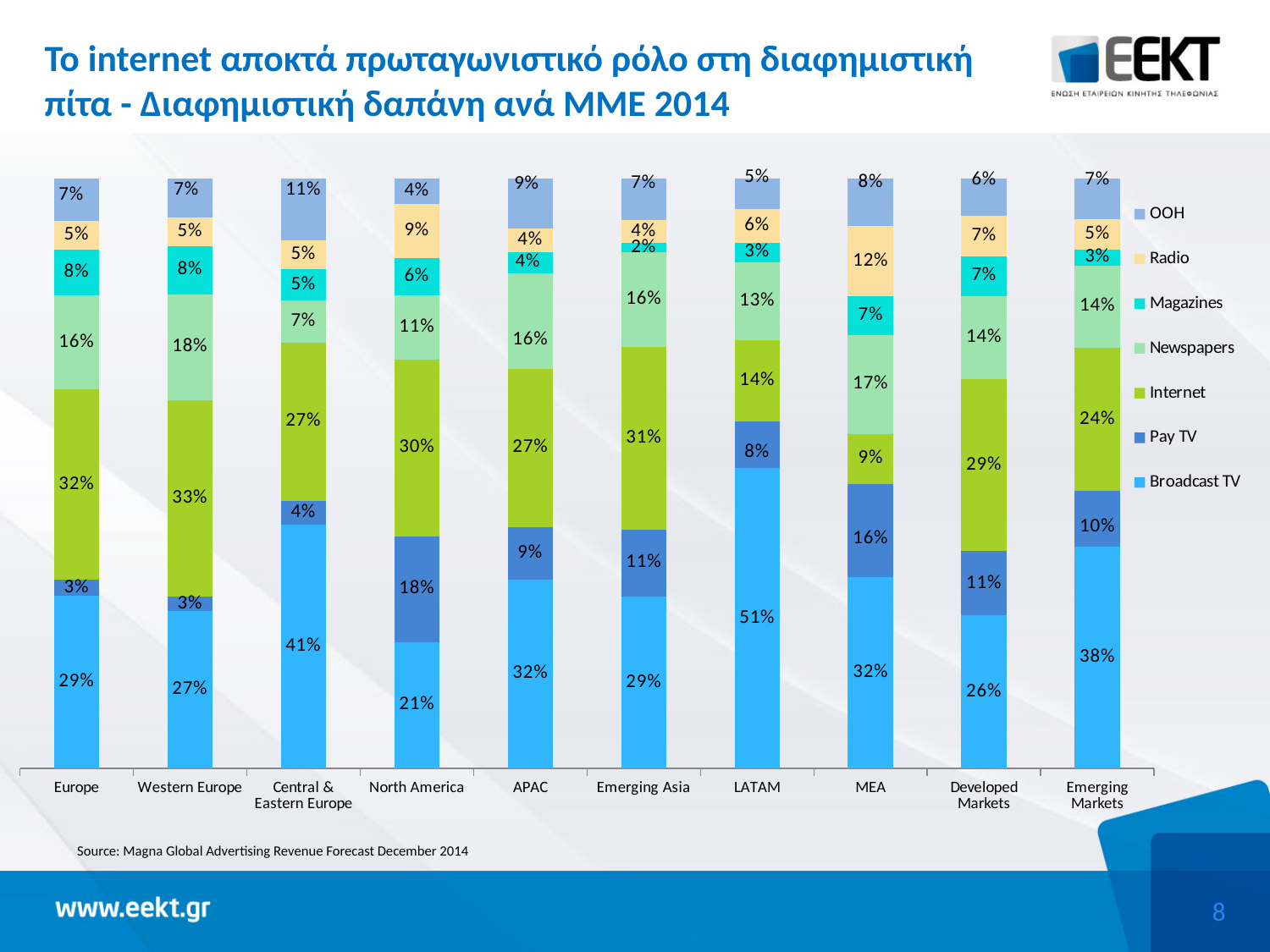
What is the Pay TV share for North America? 18% What kind of chart is shown on the slide? Stacked bar chart What is the Broadcast TV share for LATAM? 51% How many regions are shown on the x axis? 10 Which region has the highest Broadcast TV share? LATAM What is the difference between the Internet share of Western Europe and that of Central & Eastern Europe? 6% How many series does the legend list? 7 What is the Internet share of advertising spend for Europe? 32% Which legend entry is shown at the top of the legend? OOH Which is larger, the Newspapers share for MEA or for Developed Markets? MEA Which region has the lowest Internet share? MEA What is the Radio share for MEA? 12%